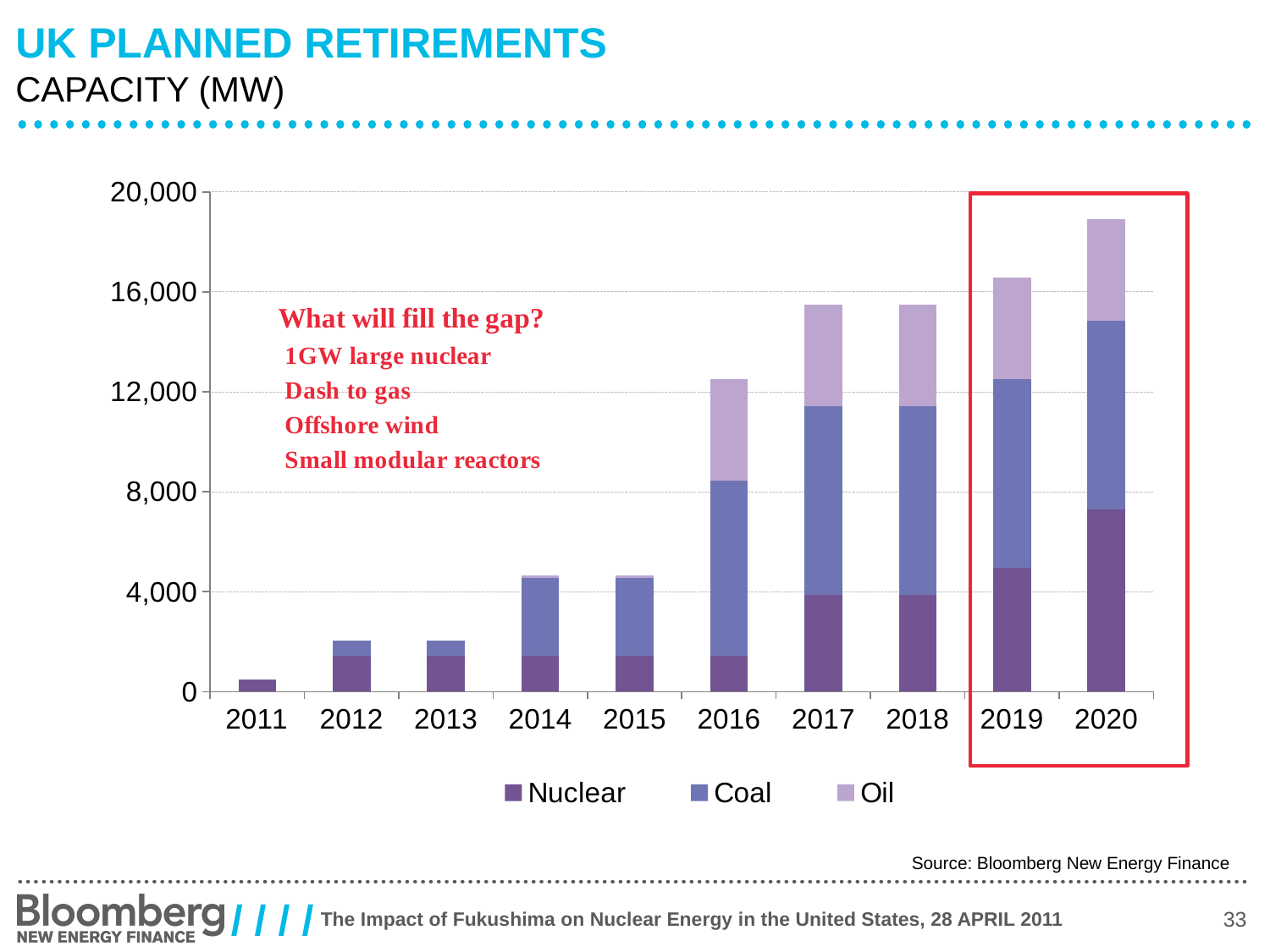
Is the total capacity for 2014 greater or less than 4,000? greater Which year has the lowest total planned retirement capacity? 2011 Is the total capacity for 2020 greater or less than 16,000? greater What kind of chart is shown on the slide? Stacked bar chart What is the title of the chart on the slide? UK PLANNED RETIREMENTS Which series is shown at the bottom of each stacked bar? Nuclear How many years are shown along the x axis of the chart? 10 Which year has a larger total capacity, 2016 or 2015? 2016 How many series does the chart's legend list? 3 Is the total capacity for 2011 greater or less than 4,000? less Do the total planned retirements generally rise or fall from 2011 to 2020? Rise Which year has the highest total planned retirement capacity? 2020